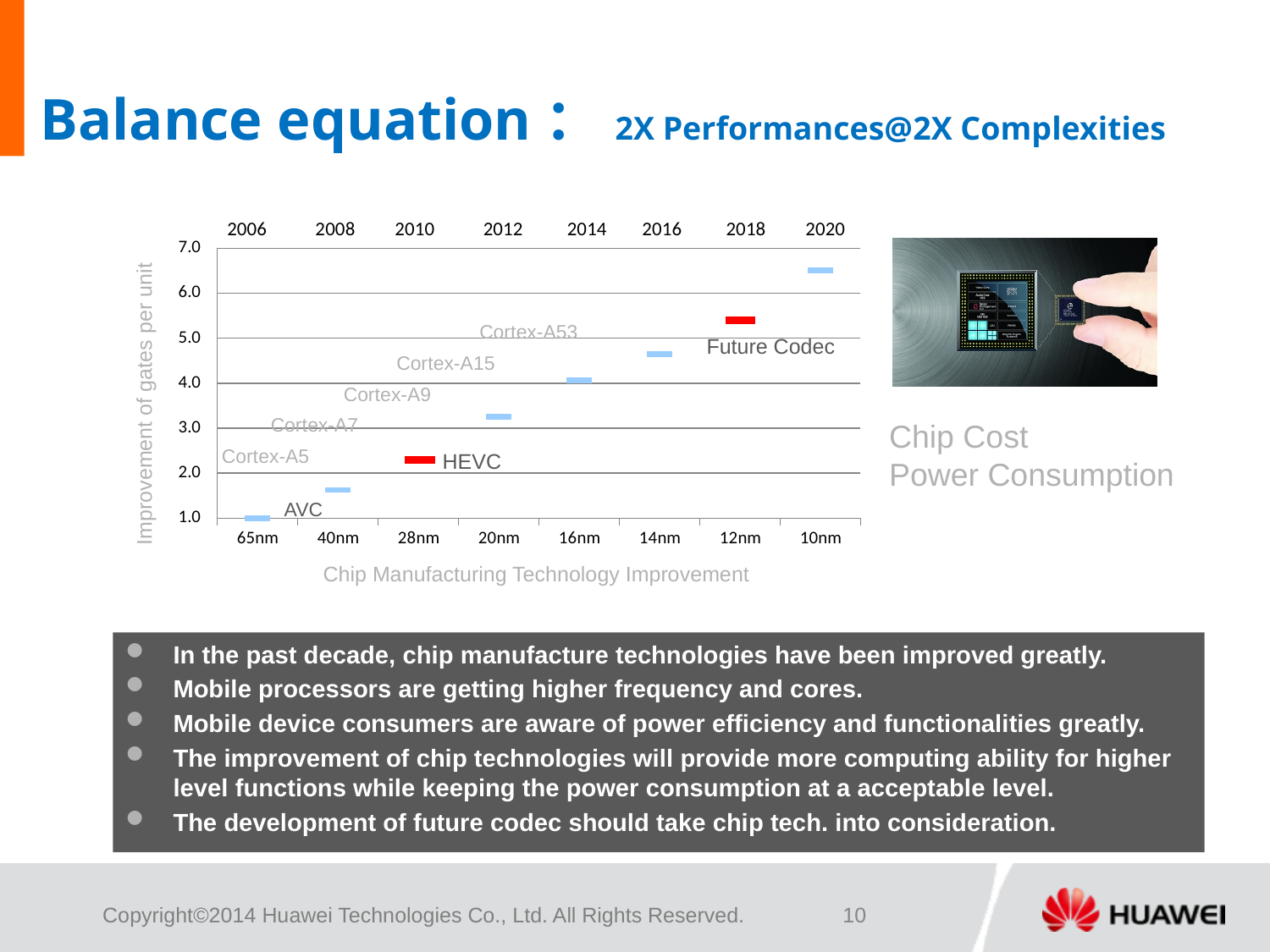
Is the plotted value for 40nm greater or less than 2.0? less Which process node has the highest plotted value in the chart? 10nm Which has the larger plotted value, 14nm or 20nm? 14nm How many process-node categories are shown on the x axis of the chart? 8 Which process node has the lowest plotted value in the chart? 65nm Which codec label is placed next to the red marker at 28nm? HEVC Is the plotted value for 12nm greater or less than 5.0? greater Is the plotted value for 20nm greater or less than 4.0? less What is the title of the chart's y axis? Improvement of gates per unit Do the plotted values rise or fall moving from 65nm to 10nm along the x axis? rise